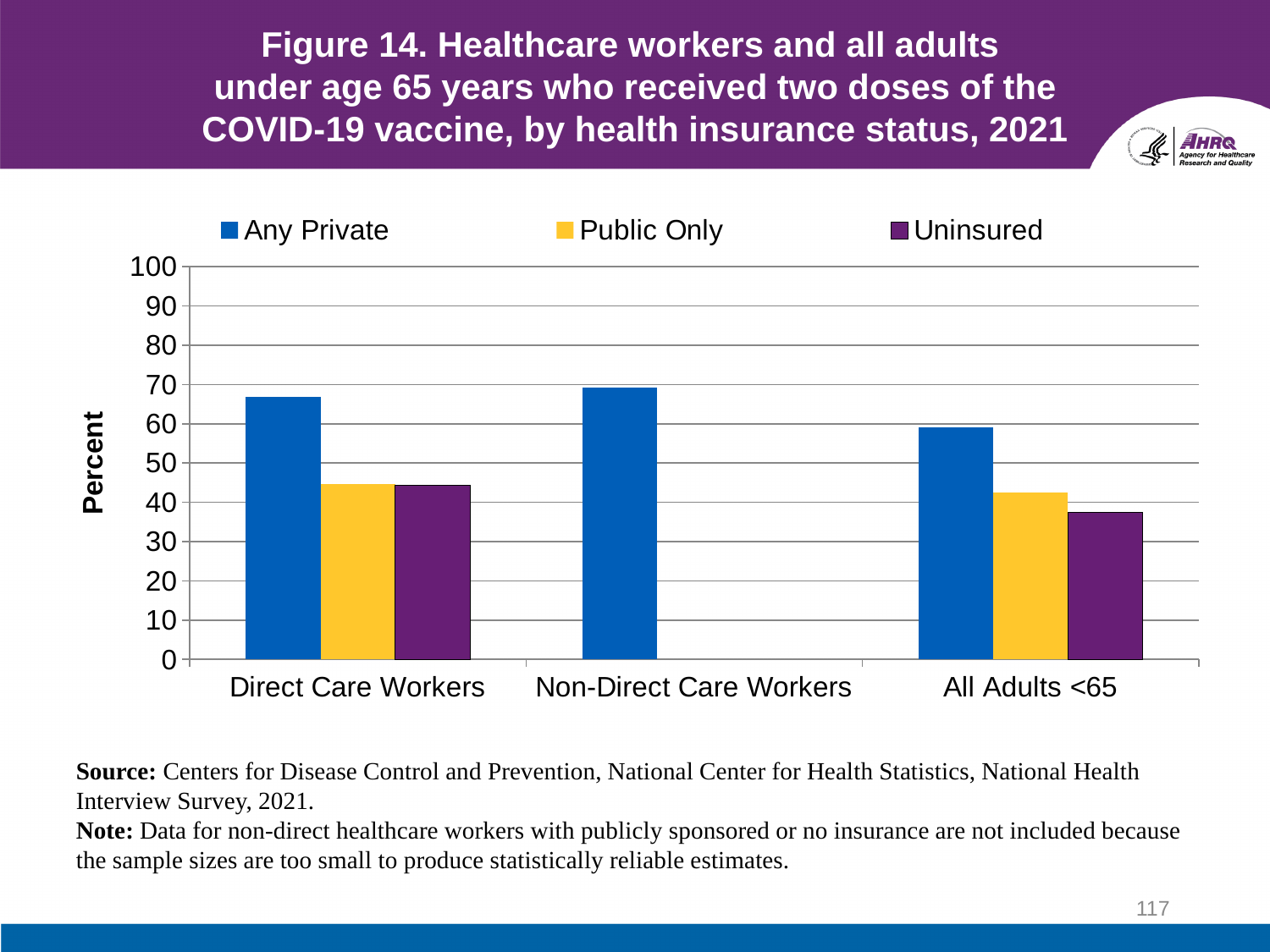
How many categories are shown on the x axis? 3 Is the Any Private value for Direct Care Workers greater or less than 60? greater What kind of chart is shown on the slide? bar chart What is the label on the y axis? Percent Is the Public Only value for Direct Care Workers greater or less than 50? less How many series does the legend list? 3 Which insurance group has the highest value among Direct Care Workers? Any Private How many bars are plotted for the Non-Direct Care Workers category? 1 Is the Any Private value for Non-Direct Care Workers greater or less than 60? greater Which is larger: the Any Private value for Direct Care Workers or the Any Private value for All Adults <65? Direct Care Workers Which insurance group has the lowest value among All Adults <65? Uninsured